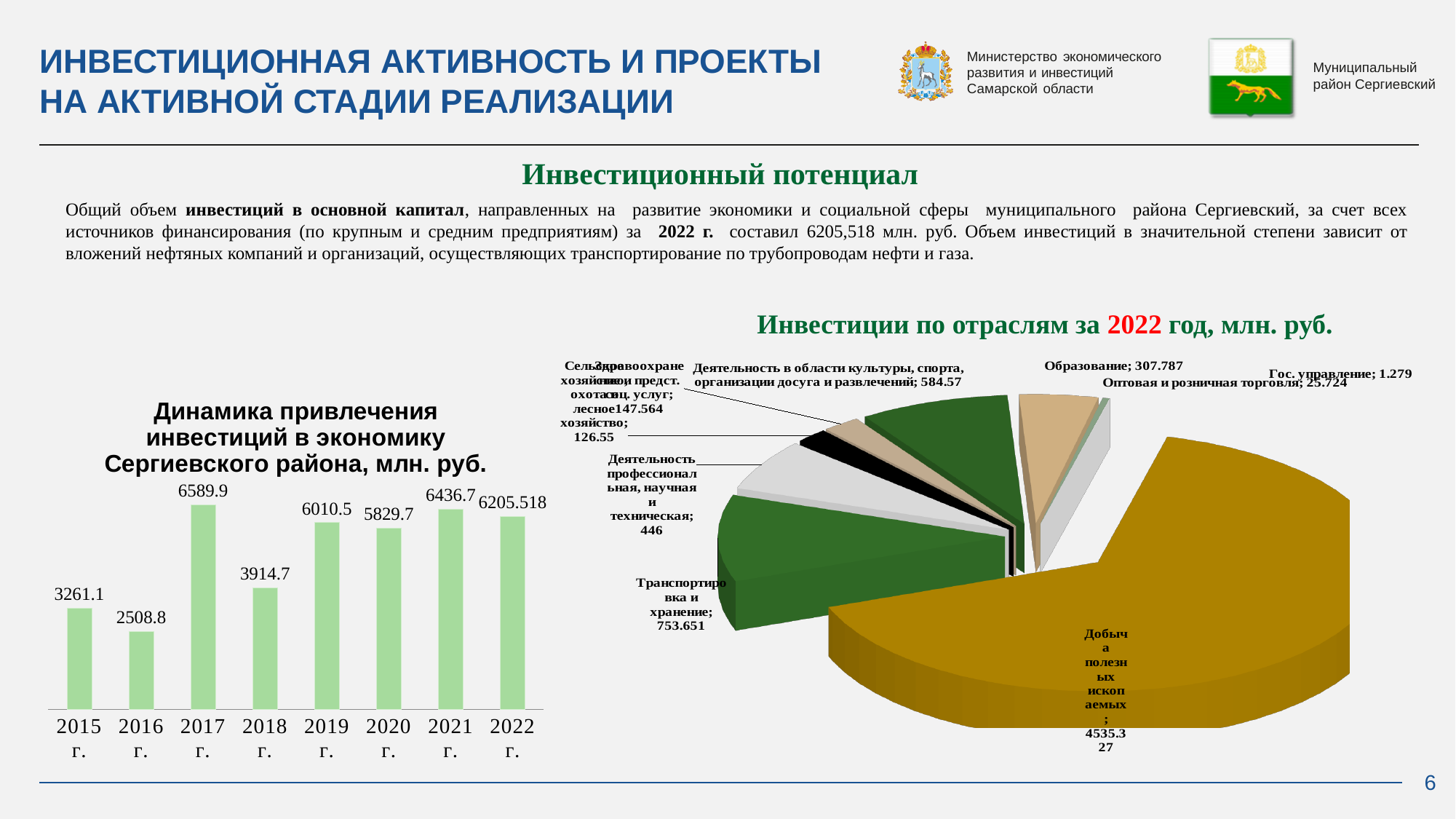
In the bar chart 'Динамика привлечения инвестиций в экономику Сергиевского района, млн. руб.', what is the value for 2022 г.? 6205.518 What type of chart is 'Динамика привлечения инвестиций в экономику Сергиевского района, млн. руб.'? bar chart In the bar chart 'Динамика привлечения инвестиций в экономику Сергиевского района, млн. руб.', what is the difference between the values for 2021 г. and 2020 г.? 607 What type of chart is 'Инвестиции по отраслям за 2022 год, млн. руб.'? pie chart How many years are shown in the bar chart 'Динамика привлечения инвестиций в экономику Сергиевского района, млн. руб.'? 8 In the bar chart 'Динамика привлечения инвестиций в экономику Сергиевского района, млн. руб.', what is the value for 2017 г.? 6589.9 In the bar chart 'Динамика привлечения инвестиций в экономику Сергиевского района, млн. руб.', which is larger: the value for 2018 г. or 2019 г.? 2019 г. In the pie chart 'Инвестиции по отраслям за 2022 год, млн. руб.', which sector has the largest slice? Добыча полезных ископаемых In the pie chart 'Инвестиции по отраслям за 2022 год, млн. руб.', what is the value for Транспортировка и хранение? 753.651 In the pie chart 'Инвестиции по отраслям за 2022 год, млн. руб.', what is the value for Добыча полезных ископаемых? 4535.327 In the bar chart 'Динамика привлечения инвестиций в экономику Сергиевского района, млн. руб.', which year has the highest value? 2017 г. In the bar chart 'Динамика привлечения инвестиций в экономику Сергиевского района, млн. руб.', which year has the lowest value? 2016 г.